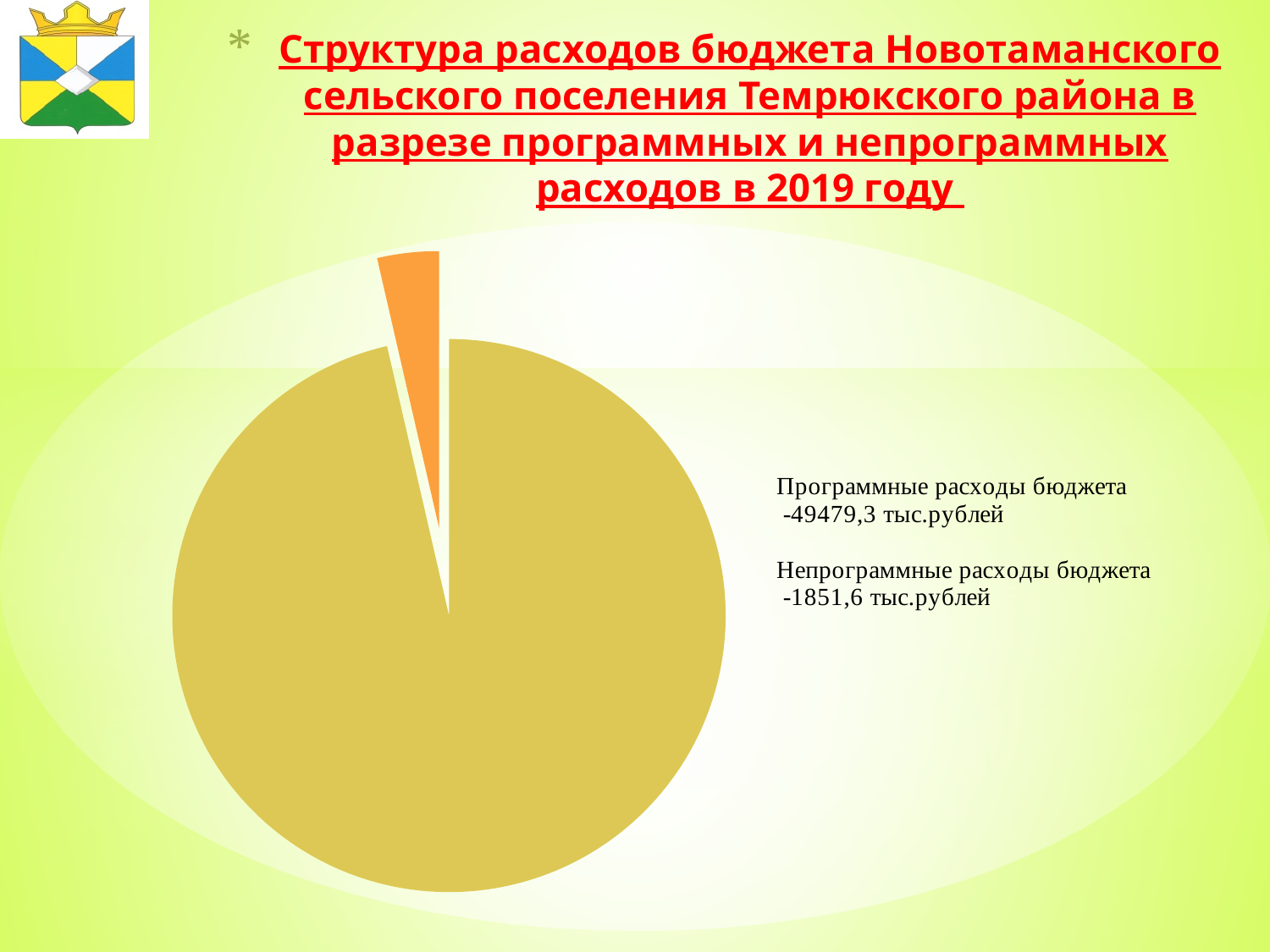
Which is larger: Программные расходы бюджета or Непрограммные расходы бюджета? Программные расходы бюджета Which category has the smallest slice of the pie? Непрограммные расходы бюджета What is the total of the two categories shown in the pie chart? 51330,9 тыс.рублей Which category has the largest slice of the pie? Программные расходы бюджета How many slices does the pie chart have? 2 What colour is the slice for Непрограммные расходы бюджета? Orange Which year does the chart title refer to? 2019 What kind of chart is shown on the slide? Pie chart What is the value of Программные расходы бюджета? 49479,3 тыс.рублей What is the difference between Программные расходы бюджета and Непрограммные расходы бюджета? 47627,7 тыс.рублей What is the value of Непрограммные расходы бюджета? 1851,6 тыс.рублей